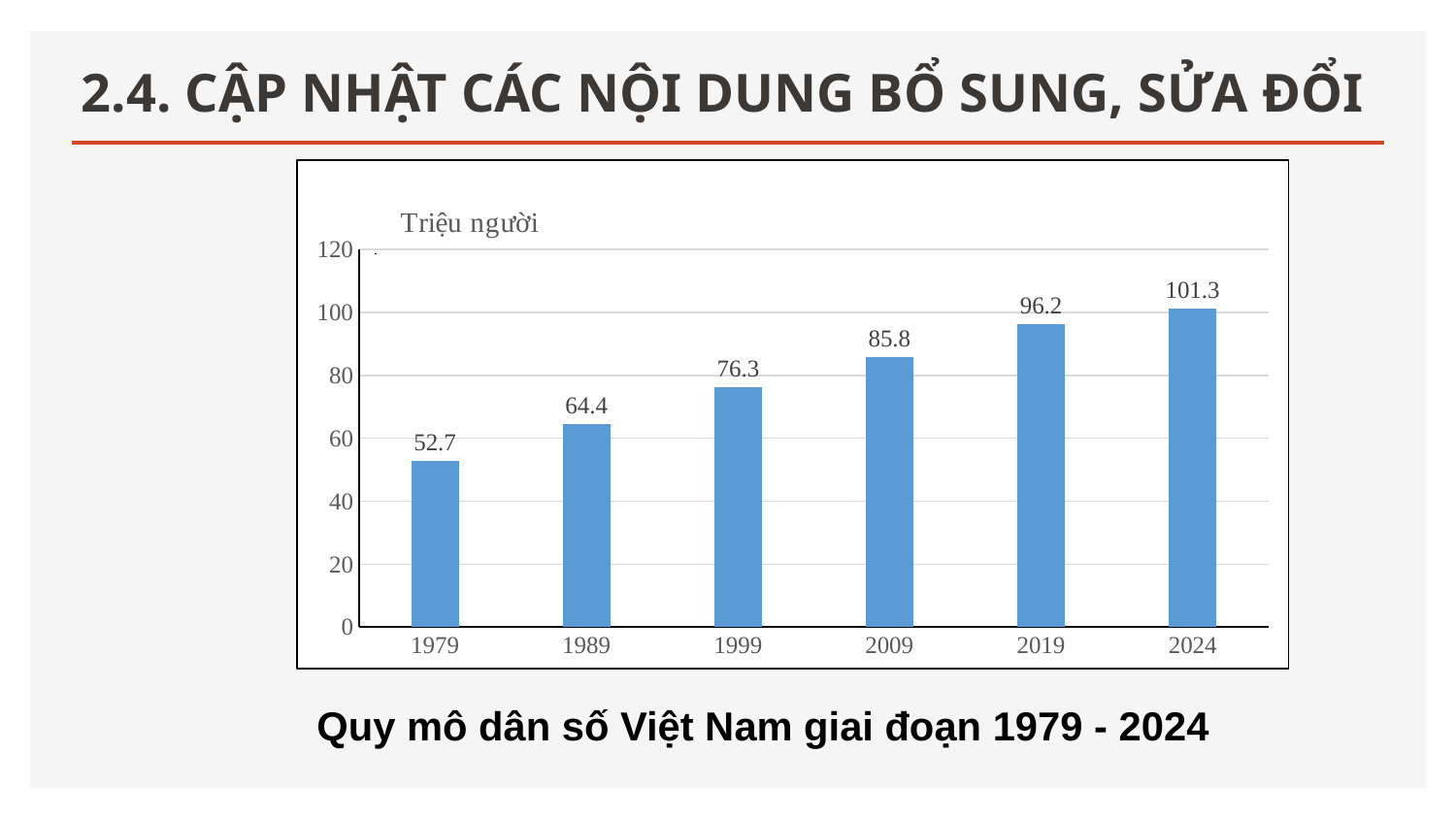
What is the value for 2009? 85.8 What is the value for 2024? 101.3 What kind of chart is shown? bar chart What is the difference between the values for 2024 and 1979? 48.6 Which year has the highest value? 2024 Do the values rise or fall from 1979 to 2024? rise Which year has the lowest value? 1979 What is the difference between the values for 2019 and 2009? 10.4 How many years are shown on the x axis? 6 Which is larger, the value for 1989 or the value for 1999? 1999 What is the value for 1979? 52.7 Is the value for 2019 greater or less than 100? less